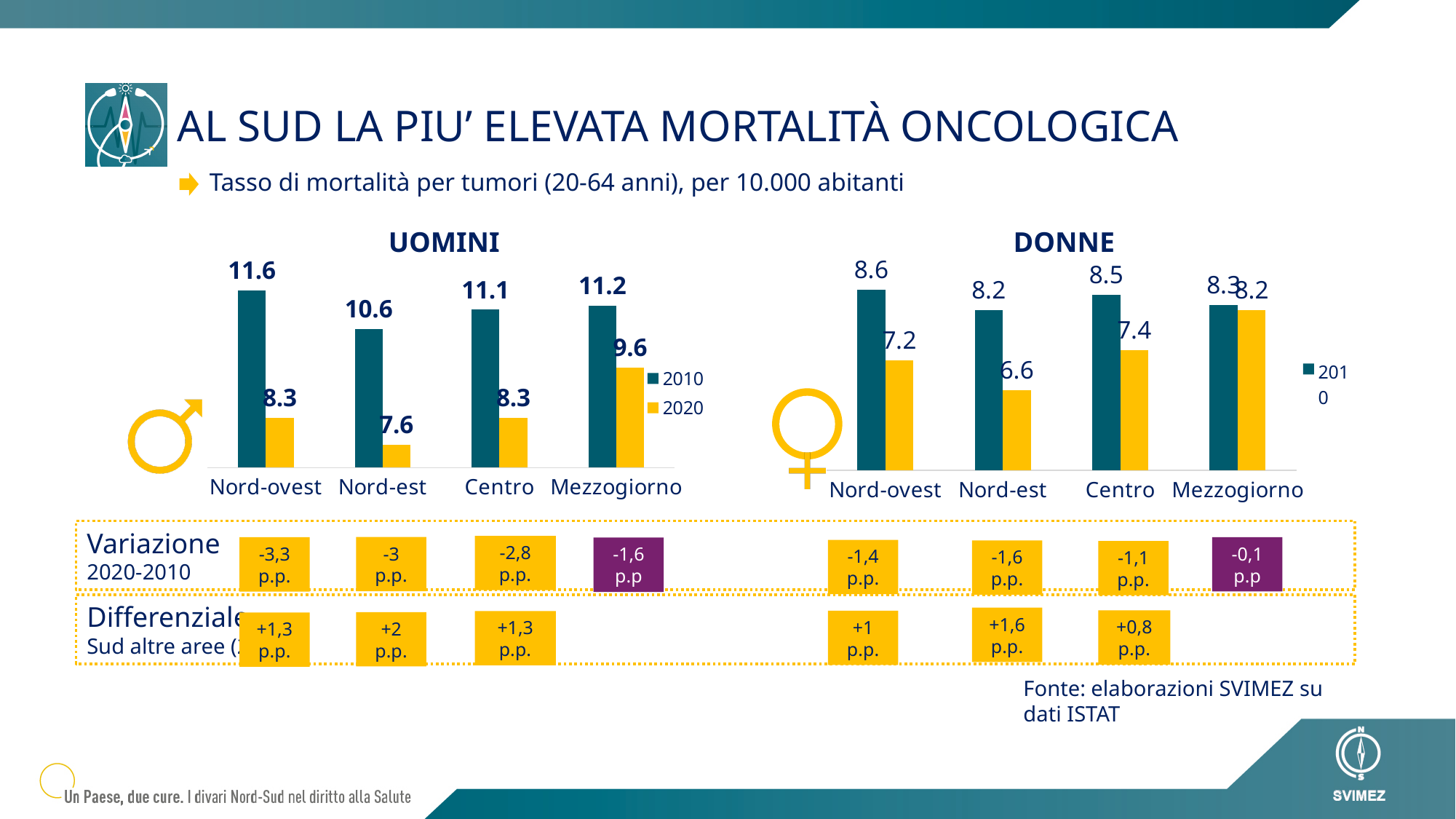
In the UOMINI chart, which region has the highest 2020 value? Mezzogiorno In the DONNE chart, which region has the highest 2020 value? Mezzogiorno In the UOMINI chart, what is the 2020 value for Mezzogiorno? 9.6 What type of chart is the UOMINI chart? Bar chart In the DONNE chart, which is larger: the 2020 value for Centro or the 2020 value for Nord-ovest? Centro In the DONNE chart, what is the 2020 value for Nord-est? 6.6 How many series does the legend of the UOMINI chart list? 2 In the UOMINI chart, which region has the lowest 2010 value? Nord-est In the UOMINI chart, what is the 2010 value for Nord-ovest? 11.6 In the DONNE chart, what is the 2010 value for Centro? 8.5 In the UOMINI chart, what is the difference between the 2010 and 2020 values for Nord-ovest? 3.3 How many regions are shown on the x axis of the DONNE chart? 4